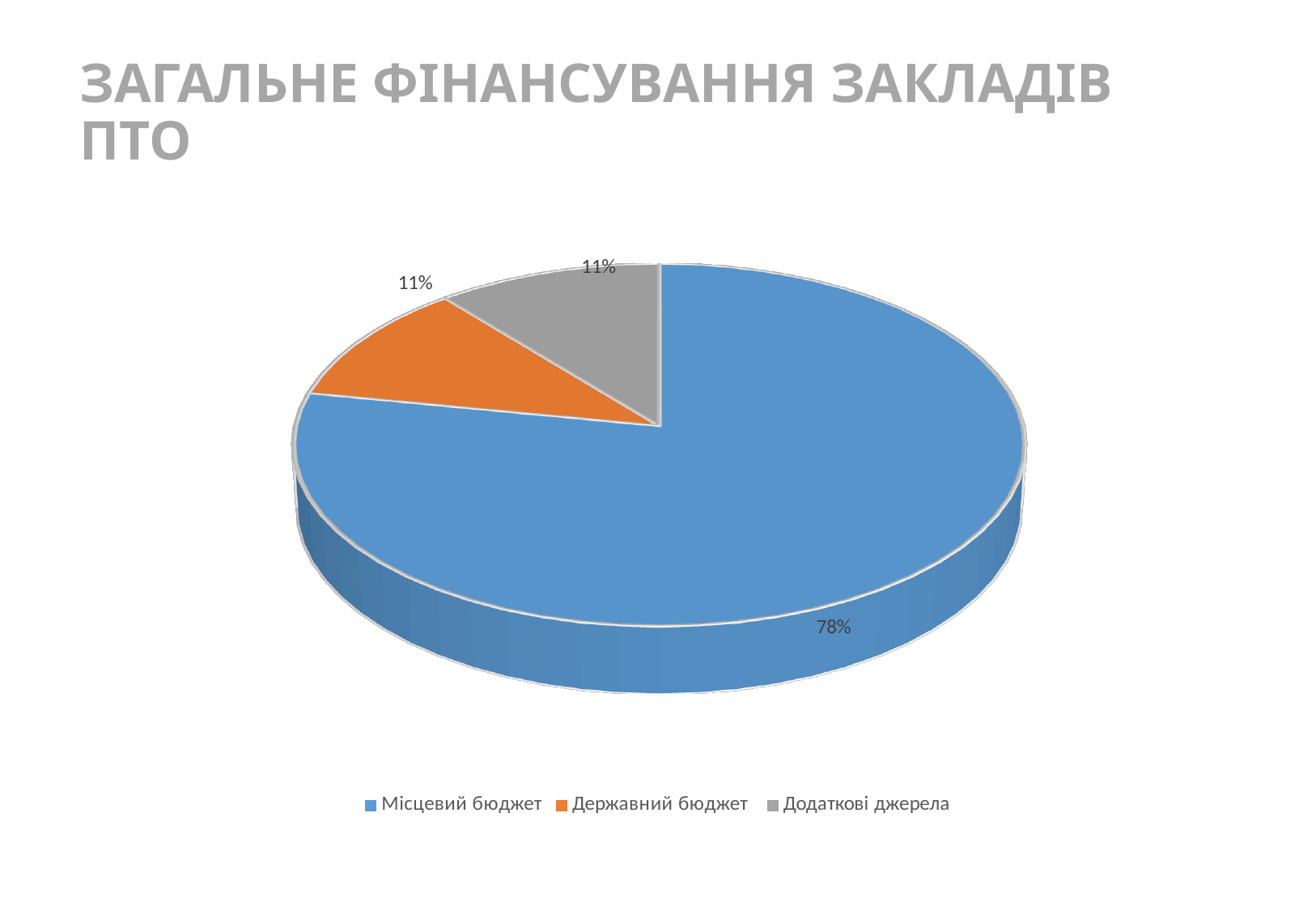
What is the title of the slide? ЗАГАЛЬНЕ ФІНАНСУВАННЯ ЗАКЛАДІВ ПТО What is the difference in percentage points between Місцевий бюджет and Державний бюджет? 67 What kind of chart is shown on the slide? Pie chart How many slices does the pie chart have? 3 What share of the pie does Місцевий бюджет account for? 78% What is the combined share of Державний бюджет and Додаткові джерела? 22% What percentage is shown for Державний бюджет? 11% What percentage is shown for Додаткові джерела? 11% How many entries does the legend list? 3 Which is larger, the share for Місцевий бюджет or the share for Додаткові джерела? Місцевий бюджет What colour is the slice for Державний бюджет? Orange Which category has the largest slice of the pie? Місцевий бюджет